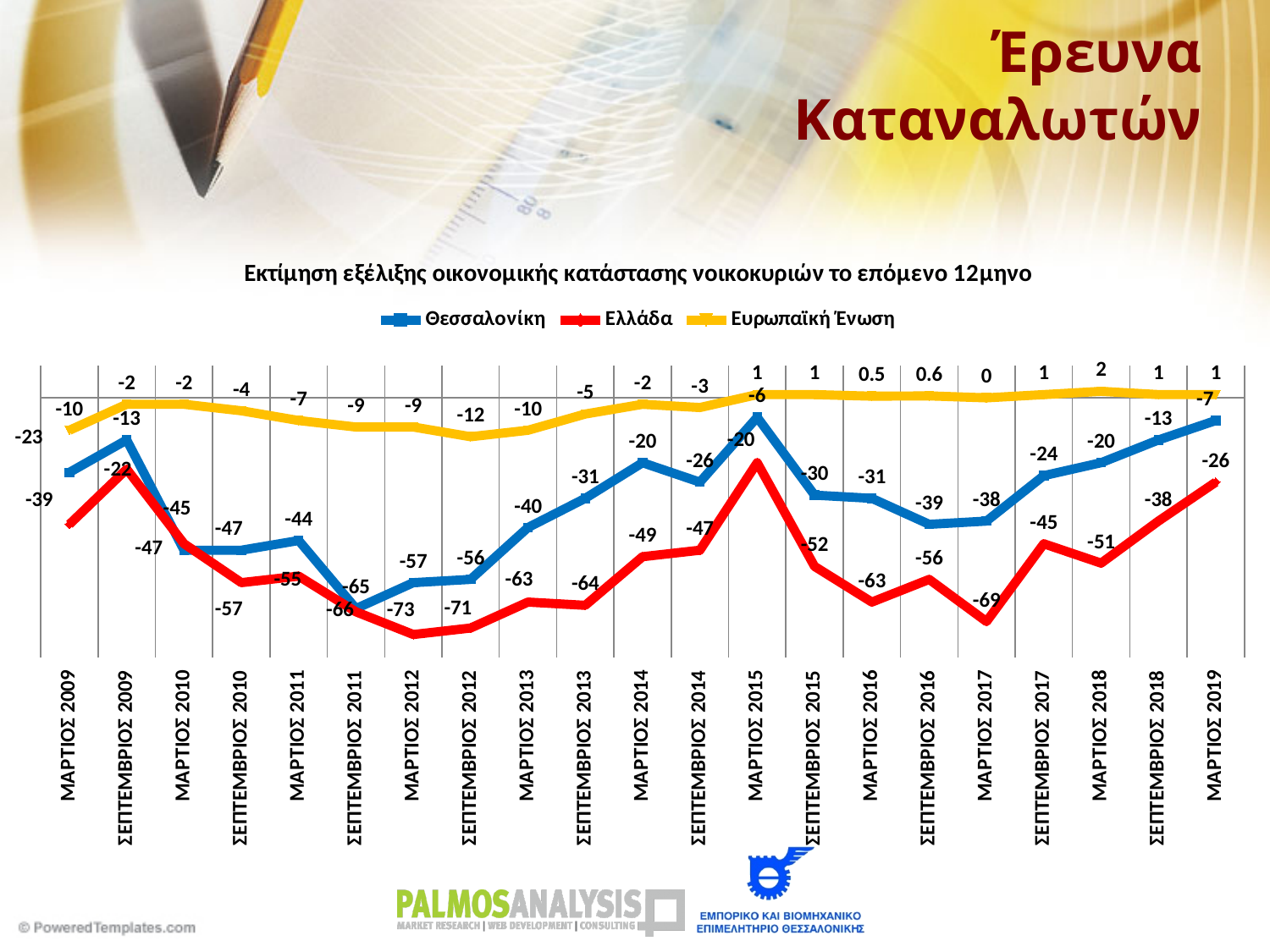
Does the Θεσσαλονίκη series rise or fall from ΜΑΡΤΙΟΣ 2017 to ΜΑΡΤΙΟΣ 2019? Rise Which series is drawn in yellow? Ευρωπαϊκή Ένωση In which period does the Ελλάδα series reach its lowest value? ΜΑΡΤΙΟΣ 2012 What is the value for Ευρωπαϊκή Ένωση in ΜΑΡΤΙΟΣ 2018? 2 How many series does the legend list? 3 How many time periods are shown on the x axis? 21 What is the difference between the Θεσσαλονίκη and Ελλάδα values in ΜΑΡΤΙΟΣ 2019? 19 What is the value for Ελλάδα in ΜΑΡΤΙΟΣ 2012? -73 What kind of chart is shown on the slide? Line chart In ΜΑΡΤΙΟΣ 2017, which series has the higher value, Θεσσαλονίκη or Ελλάδα? Θεσσαλονίκη In which period does the Θεσσαλονίκη series reach its highest value? ΜΑΡΤΙΟΣ 2015 What is the value for Θεσσαλονίκη in ΜΑΡΤΙΟΣ 2015? -6